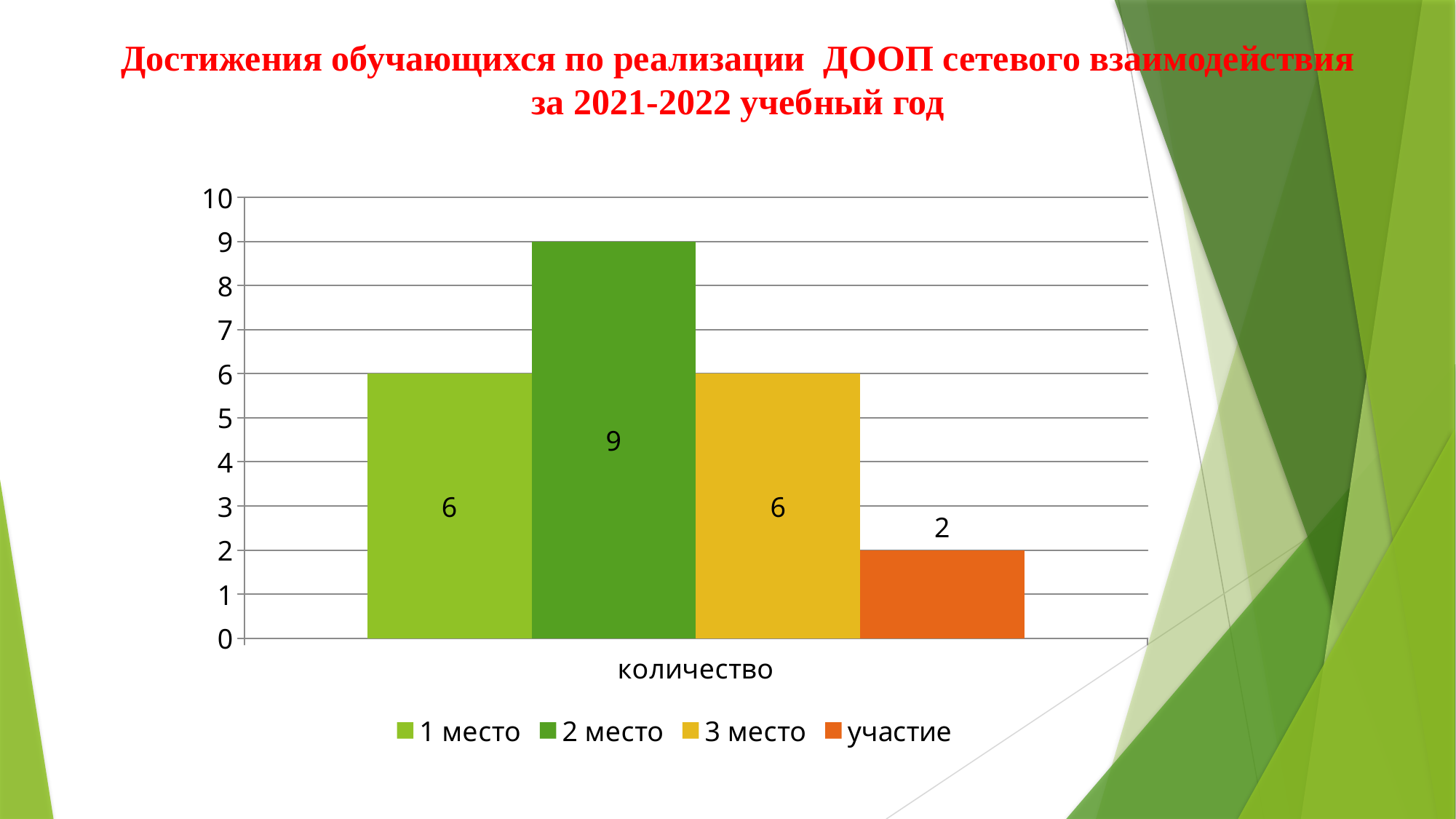
What is the difference between the values for "2 место" and "3 место"? 3 How many series does the legend list? 4 What is the value for "1 место"? 6 Which series has the highest value? 2 место What is the label on the x axis under the bars? количество Which series has the lowest value? участие Which is larger, the value for "3 место" or the value for "участие"? 3 место What is the difference between the values for "2 место" and "участие"? 7 What colour is the bar for "участие"? orange What kind of chart is shown on the slide? bar chart What is the value for "2 место"? 9 What is the value for "участие"? 2